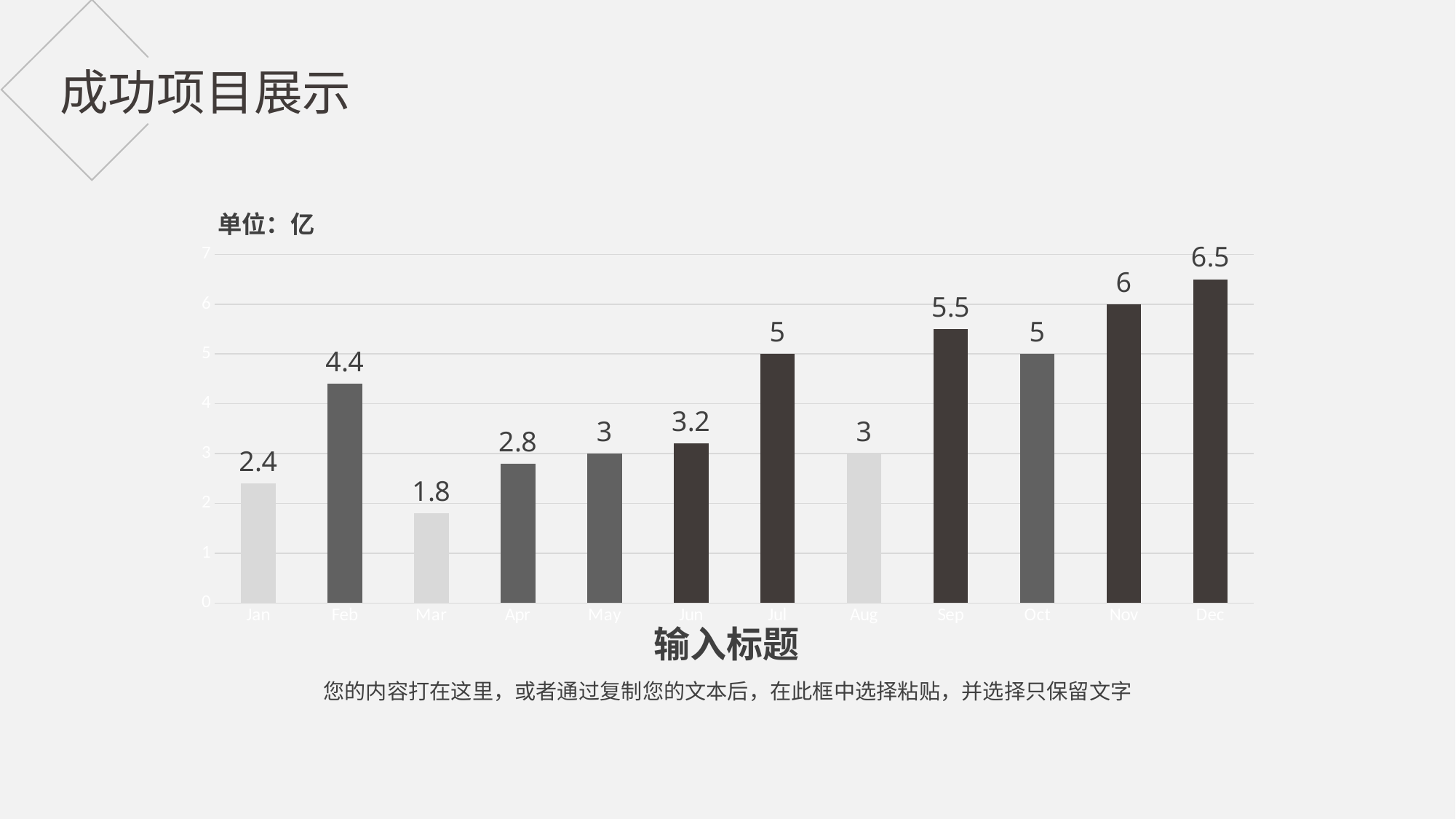
Do the values generally rise or fall from Aug to Dec? rise Which month has the highest value? Dec What is the value for Mar? 1.8 Which month has the lowest value? Mar What unit is stated above the chart? 亿 Is the value for Nov greater or less than 5? greater What is the difference between the values for Dec and Jan? 4.1 Which is larger, the value for Feb or the value for Jun? Feb How many months are shown on the x axis? 12 What is the value for Sep? 5.5 What is the value for Feb? 4.4 What kind of chart is shown on the slide? bar chart